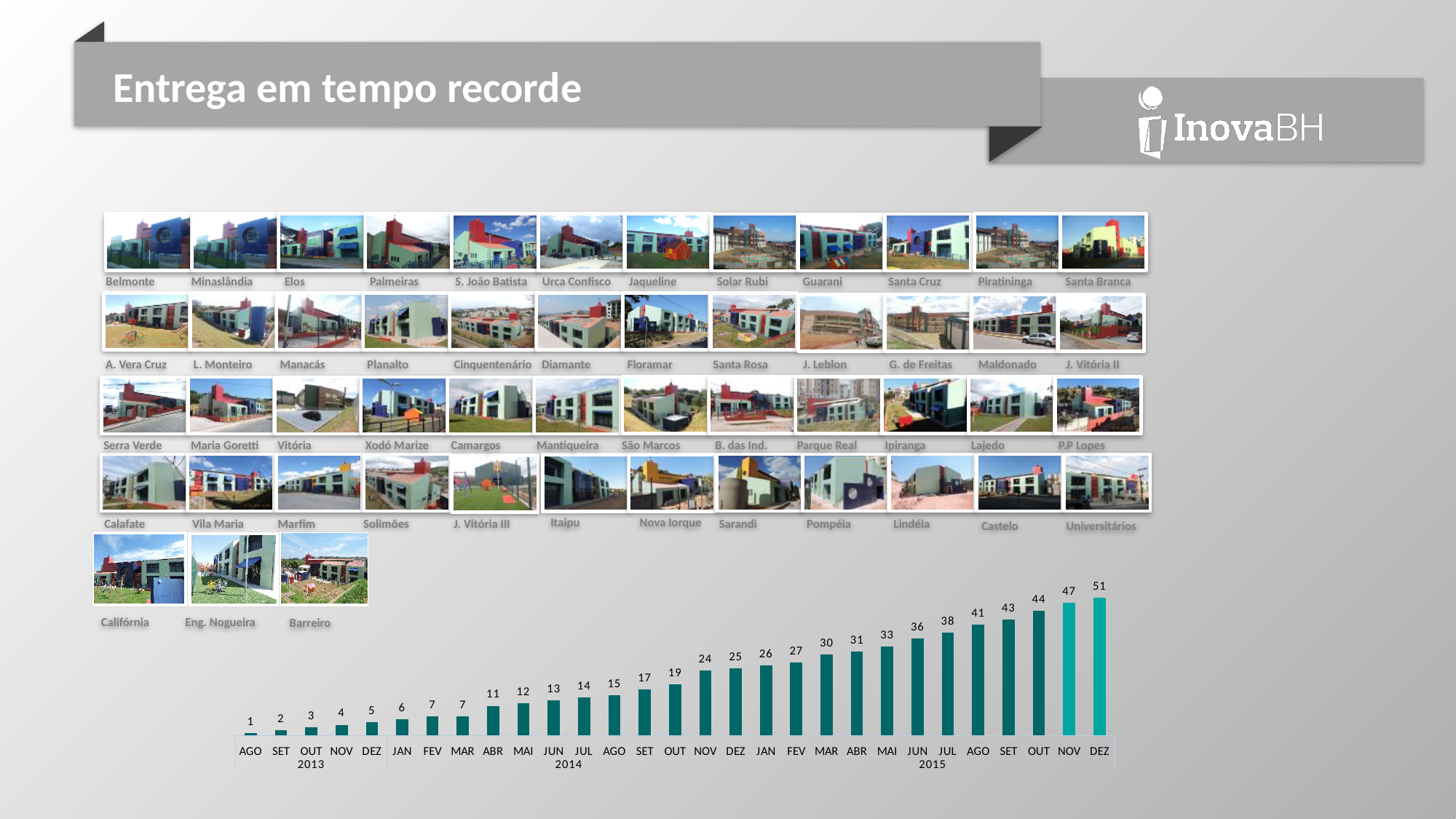
What is the difference between the values for DEZ 2015 and DEZ 2014? 26 What value is shown for AGO 2013 in the bar chart? 1 What kind of chart is shown at the bottom of the slide? Bar chart Which month has the lowest value in the bar chart? AGO 2013 Which is larger, the value for MAR 2014 or the value for ABR 2014? ABR 2014 Which month has the highest value in the bar chart? DEZ 2015 Which two bars in the chart are drawn in a lighter shade than the others? NOV 2015 and DEZ 2015 What value is shown for JAN 2015 in the bar chart? 26 What value is shown for DEZ 2015 in the bar chart? 51 What value is shown for NOV 2014 in the bar chart? 24 How many bars are plotted in the bar chart? 29 Do the values in the bar chart rise or fall from AGO 2013 to DEZ 2015? Rise